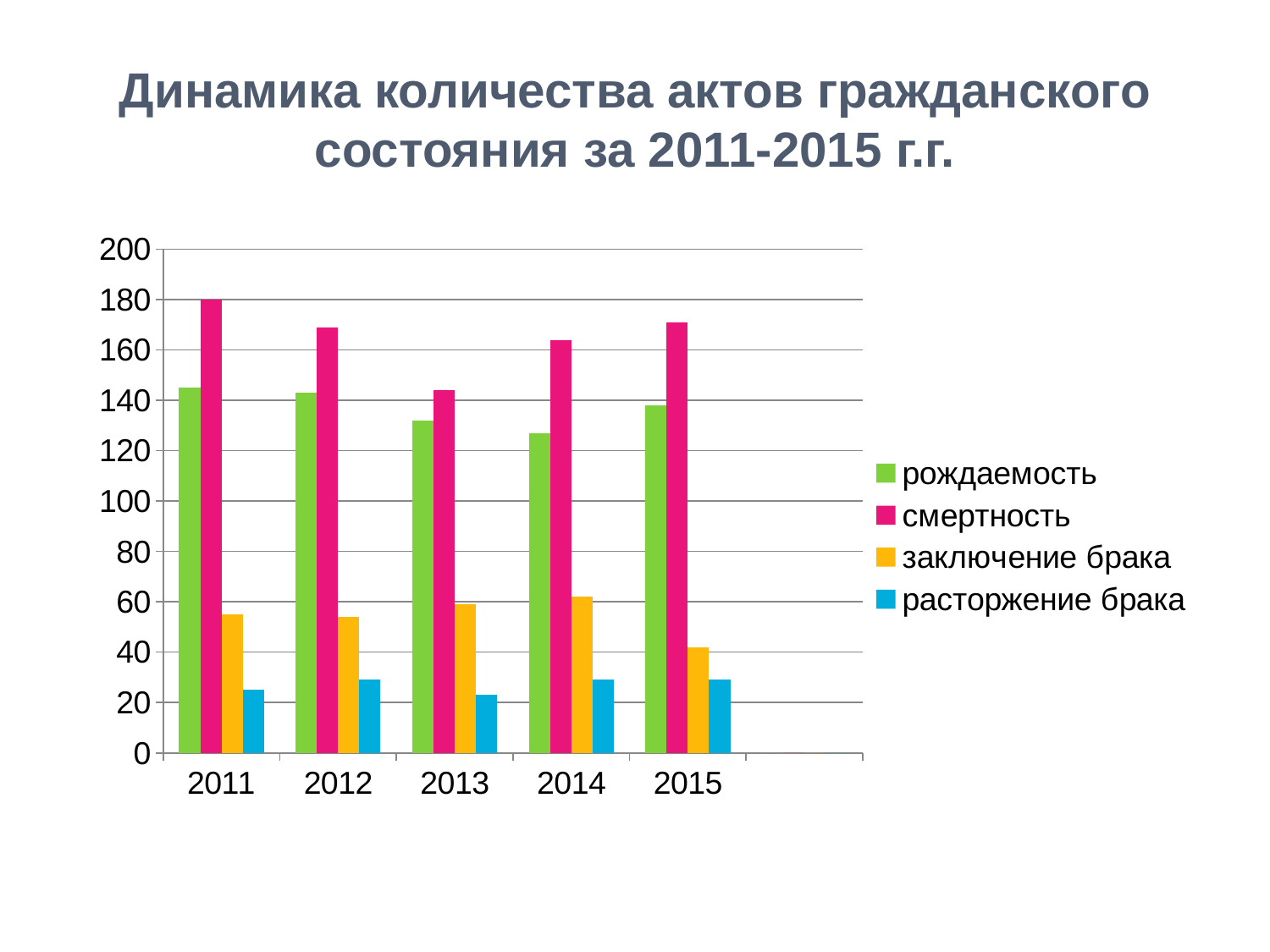
How many years are shown on the x axis? 5 Does the value for смертность rise or fall from 2011 to 2013? fall Is the value for смертность in 2011 greater or less than 160? greater Which colour represents расторжение брака in the legend? blue Is the value for заключение брака in 2015 greater or less than 60? less In which year is the value for смертность highest? 2011 How many series does the legend list? 4 In which year is the value for смертность lowest? 2013 In 2013, which is larger: рождаемость or смертность? смертность In which year is the value for заключение брака lowest? 2015 Is the value for рождаемость in 2014 greater or less than 140? less What kind of chart is shown on the slide? bar chart